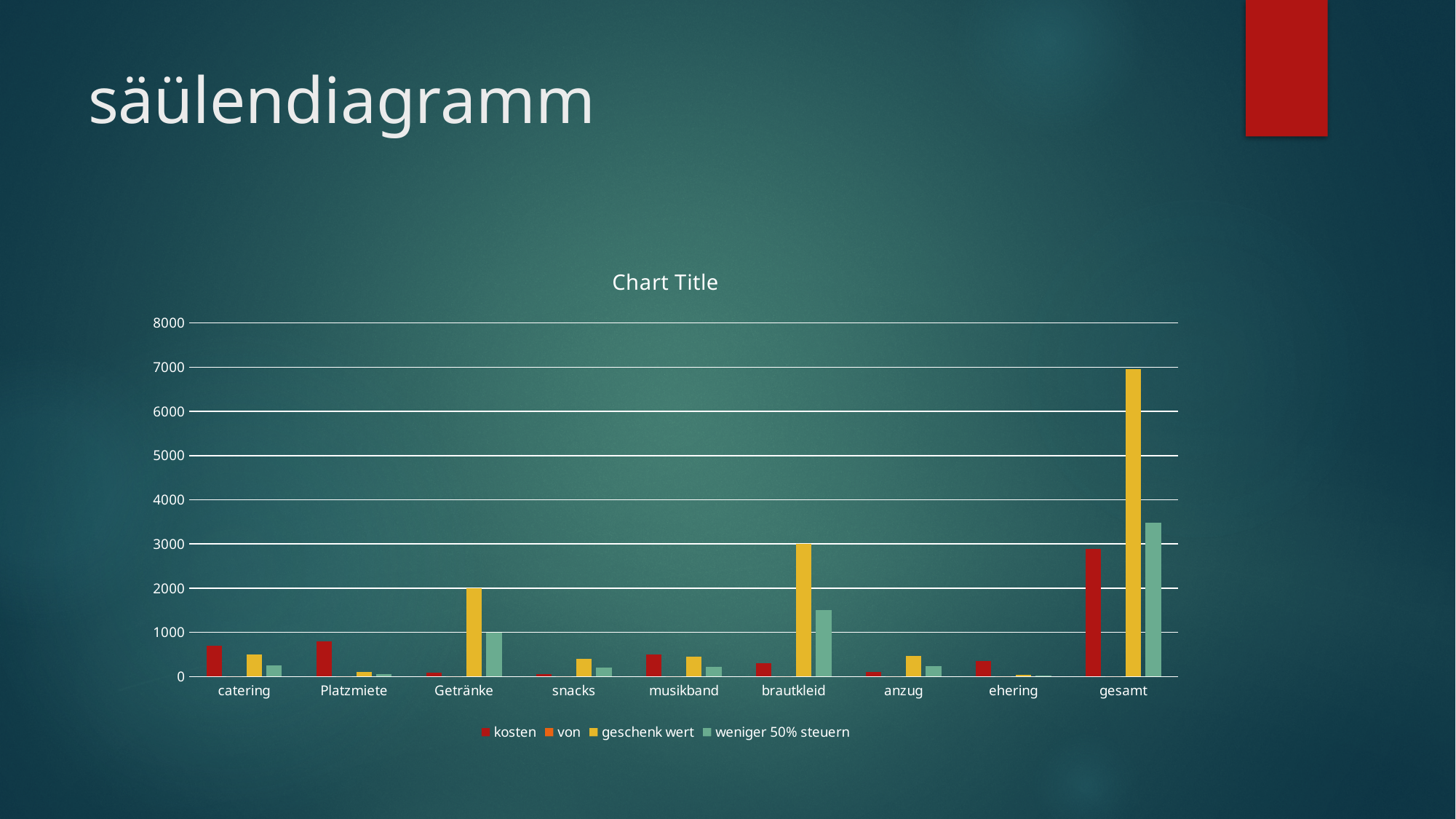
How many categories are shown on the x axis of the chart? 9 Which category has the highest 'geschenk wert' bar? gesamt Is the 'kosten' value for gesamt greater or less than 2000? greater What is the title shown above the chart? Chart Title How many series does the chart's legend list? 4 Is the 'kosten' value for catering greater or less than 1000? less Which is larger for gesamt: the 'geschenk wert' value or the 'kosten' value? geschenk wert Is the 'geschenk wert' value for gesamt greater or less than 6000? greater Which category has the highest 'kosten' bar? gesamt What kind of chart is shown on the slide? bar chart Which is larger: the 'geschenk wert' value for brautkleid or for Getränke? brautkleid